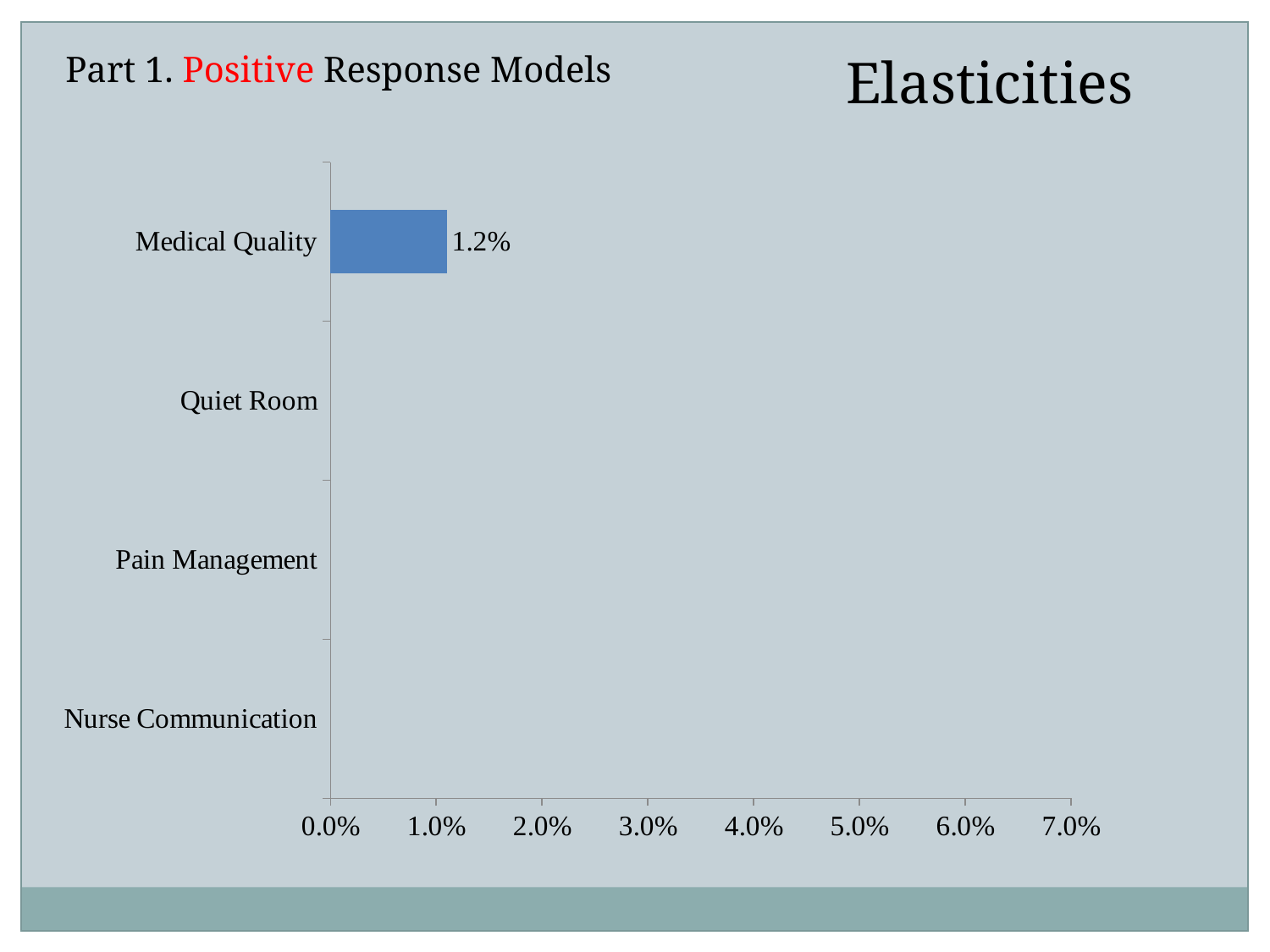
What is the title shown above the chart on the right side of the slide? Elasticities What is the value shown for Medical Quality? 1.2% How many categories are listed on the vertical axis of the chart? 4 What is the highest value labelled on the horizontal axis? 7.0% Is the value for Medical Quality greater or less than 1.0%? greater How many bars are plotted on the chart? 1 Which category is the only one with a plotted bar on the chart? Medical Quality Which category is listed at the bottom of the vertical axis? Nurse Communication What kind of chart is shown on the slide? bar chart Is the value for Medical Quality greater or less than 2.0%? less